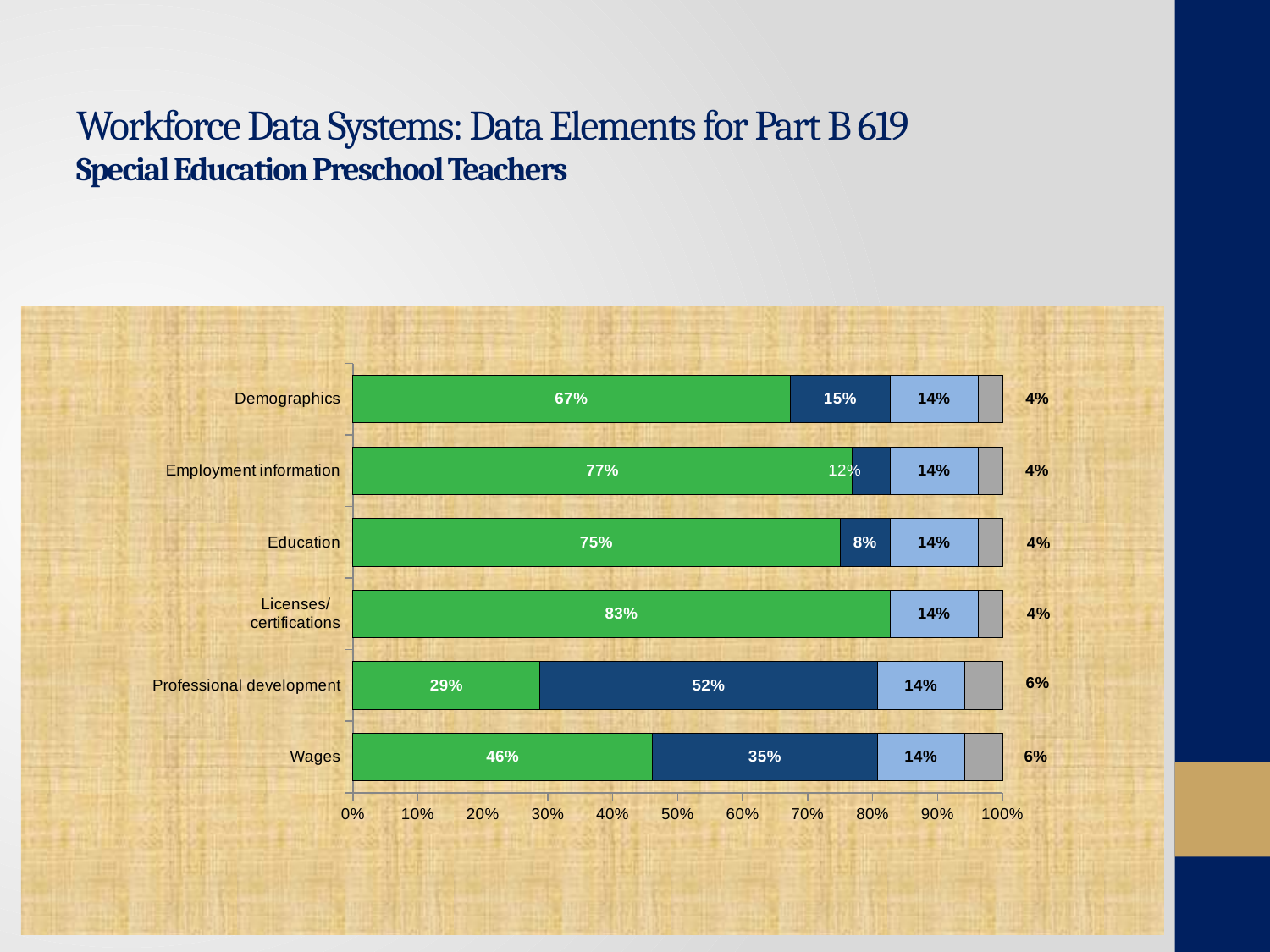
Which has a larger dark blue segment, Wages or Demographics? Wages Which category has the largest green segment? Licenses/certifications What kind of chart is shown on the slide? Stacked bar chart What is the value of the green segment for Demographics? 67% What is the value of the gray segment for Wages? 6% What is the highest value shown on the x axis? 100% What is the value of the dark blue segment for Professional development? 52% What is the total of the stacked bar for Demographics? 100% What is the value of the light blue segment for Education? 14% What is the difference between the green segment for Employment information and the green segment for Education? 2% Which category has the smallest green segment? Professional development How many categories are shown on the chart? 6